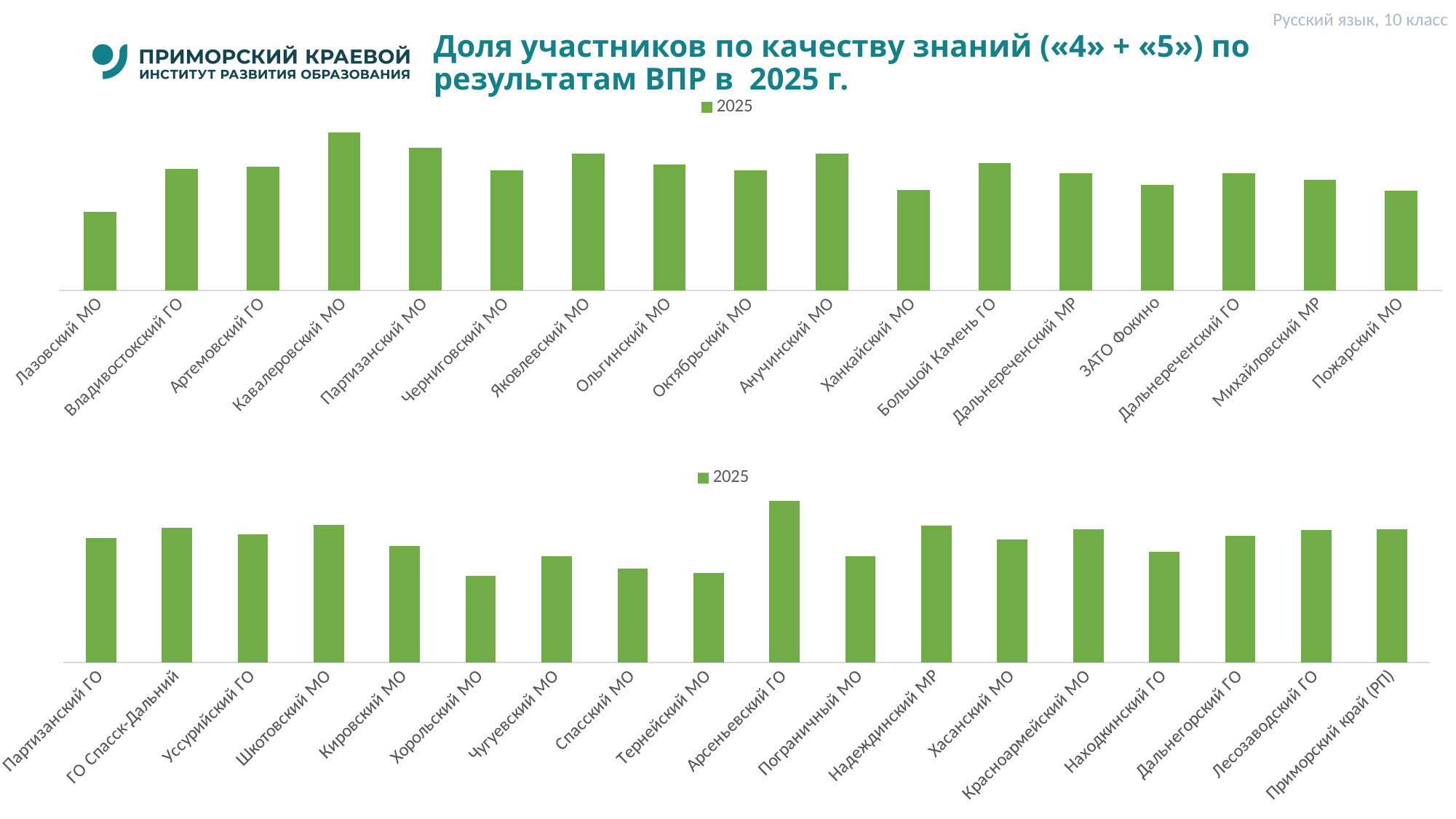
In the bottom chart, which is larger: the value for Шкотовский МО or the value for Хорольский МО? Шкотовский МО In the bottom chart, which is larger: the value for Кировский МО or the value for Спасский МО? Кировский МО How many categories are shown in the bottom chart? 18 What is the title of the charts on the slide? Доля участников по качеству знаний («4» + «5») по результатам ВПР в 2025 г. How many categories are shown in the top chart? 17 In the top chart, which is larger: the value for Партизанский МО or the value for Ханкайский МО? Партизанский МО How many series does the legend of the top chart list? 1 In the top chart, which category has the lowest value? Лазовский МО What series name is shown in the legend of the bottom chart? 2025 In the top chart, which category has the highest value? Кавалеровский МО In the bottom chart, which category has the highest value? Арсеньевский ГО What kind of chart is the top chart on the slide? bar chart